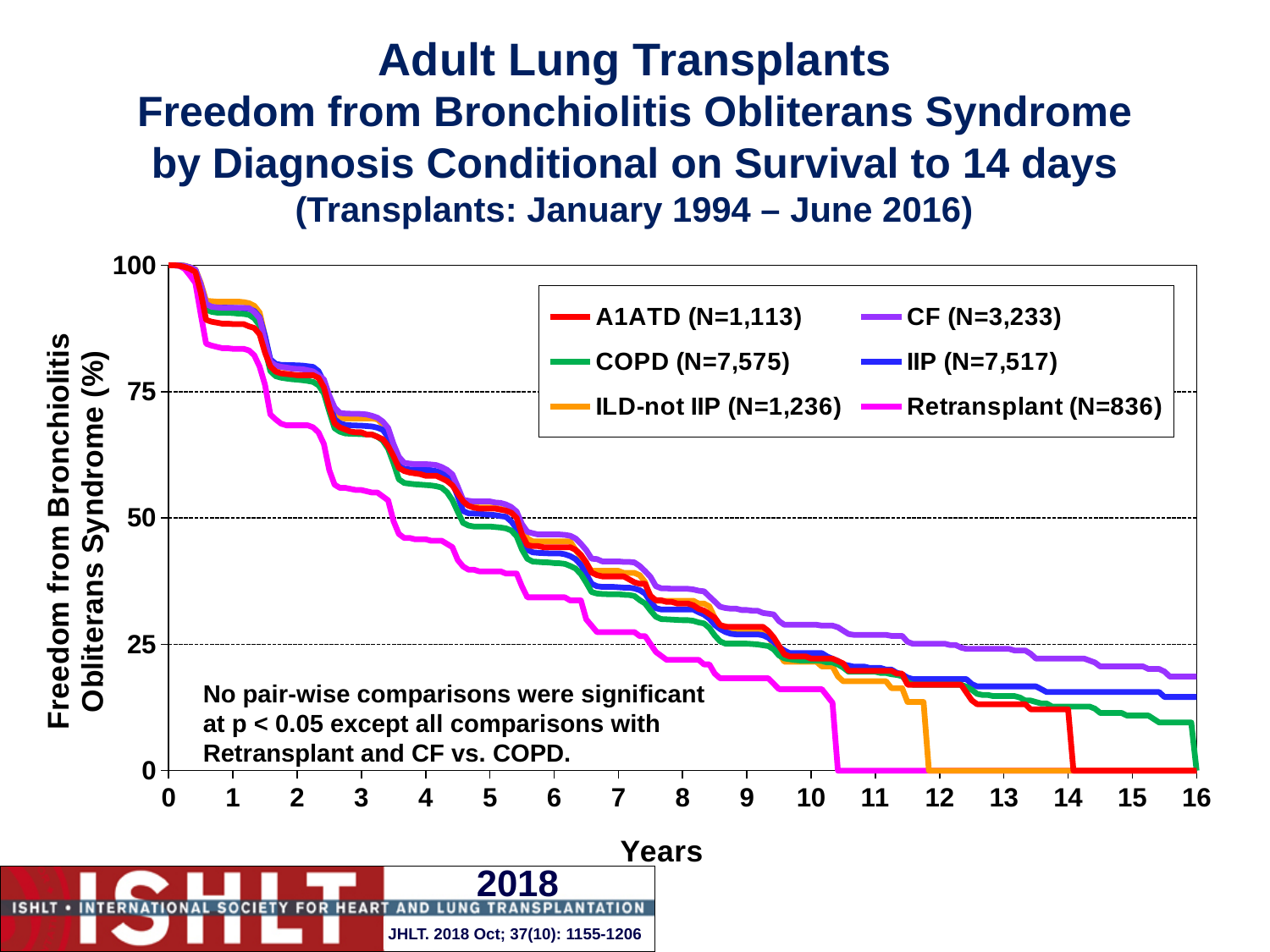
Which diagnosis group has the highest freedom from bronchiolitis obliterans syndrome at 14 years? CF What is the maximum value shown on the x axis (Years)? 16 What kind of chart is shown on the slide? Line chart Is the value for CF at 16 years greater or less than 25? less At 12 years, is the value for CF or COPD larger? CF How many series does the legend list? 6 According to the legend, what is the N for COPD? N=7,575 Do the curves rise or fall as the number of years increases? Fall Is the value for Retransplant at 5 years greater or less than 50? less Is the value for Retransplant at 2 years greater or less than 50? greater Which diagnosis group has the lowest freedom from bronchiolitis obliterans syndrome at 5 years? Retransplant